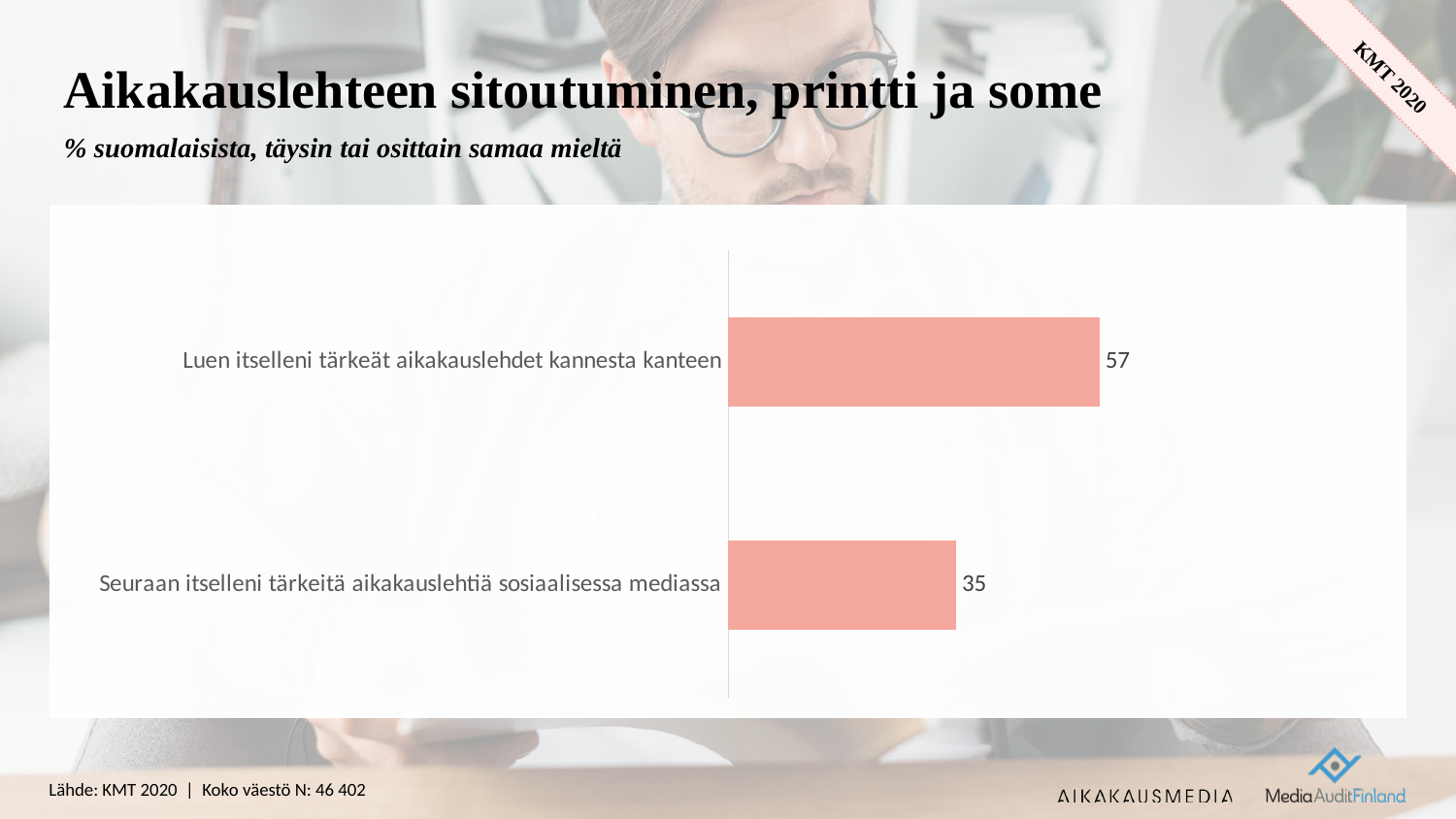
How many categories are shown in the chart? 2 Which is larger: the value for reading magazines cover to cover ("Luen itselleni tärkeät aikakauslehdet kannesta kanteen") or following magazines on social media ("Seuraan itselleni tärkeitä aikakauslehtiä sosiaalisessa mediassa")? Luen itselleni tärkeät aikakauslehdet kannesta kanteen Which category has the lowest value? Seuraan itselleni tärkeitä aikakauslehtiä sosiaalisessa mediassa What is the subtitle describing what the chart values represent? % suomalaisista, täysin tai osittain samaa mieltä What is the difference between the values for "Luen itselleni tärkeät aikakauslehdet kannesta kanteen" and "Seuraan itselleni tärkeitä aikakauslehtiä sosiaalisessa mediassa"? 22 What is the value for "Seuraan itselleni tärkeitä aikakauslehtiä sosiaalisessa mediassa"? 35 What kind of chart is shown on the slide? Bar chart Which category has the highest value? Luen itselleni tärkeät aikakauslehdet kannesta kanteen What is the title of the slide containing the chart? Aikakauslehteen sitoutuminen, printti ja some What is the value for "Luen itselleni tärkeät aikakauslehdet kannesta kanteen"? 57